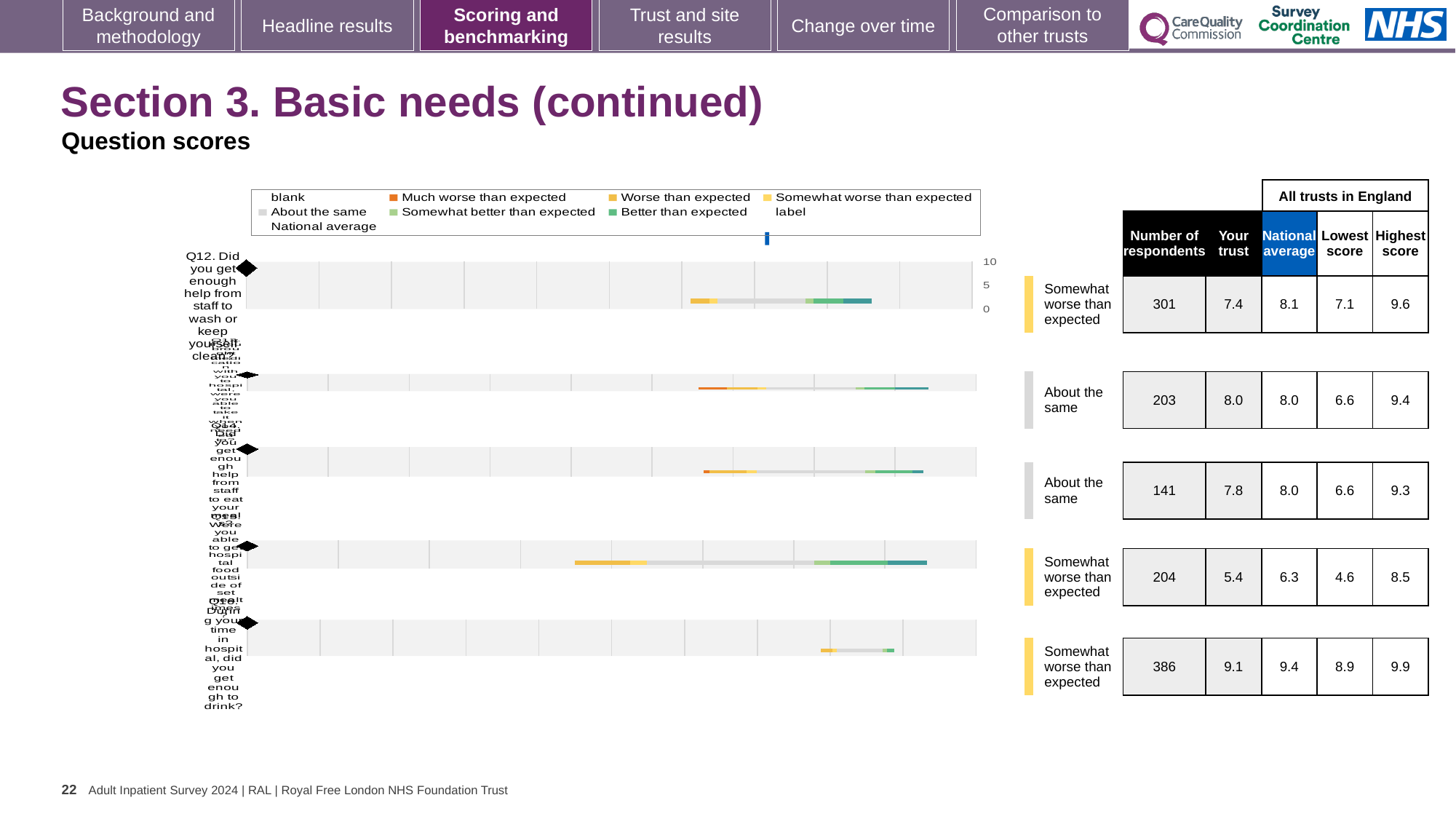
In the table beside the chart, is the 'Your trust' score for Q14 higher or lower than the national average? lower In the table beside the chart, what is the national average for Q12? 8.1 In the table beside the chart, which row has the highest 'Your trust' score? the fifth (bottom) row, 9.1 What benchmark category is given for Q12 next to the chart? Somewhat worse than expected Which legend entry is shown in orange, between 'blank' and 'Worse than expected'? Much worse than expected How many question rows (bars) does the chart show? 5 In the table beside the chart, what is the 'Your trust' score for Q12 (help from staff to wash or keep yourself clean)? 7.4 In the table beside the chart, which row has the lowest 'Your trust' score? the fourth row, 5.4 In the table beside the chart, how many respondents are listed for Q14 (help from staff to eat your meals)? 141 What is the highest value shown on the chart's axis? 10 In the table beside the chart, what is the difference between the national average and the 'Your trust' score for Q12? 0.7 What kind of chart is shown on the slide? bar chart